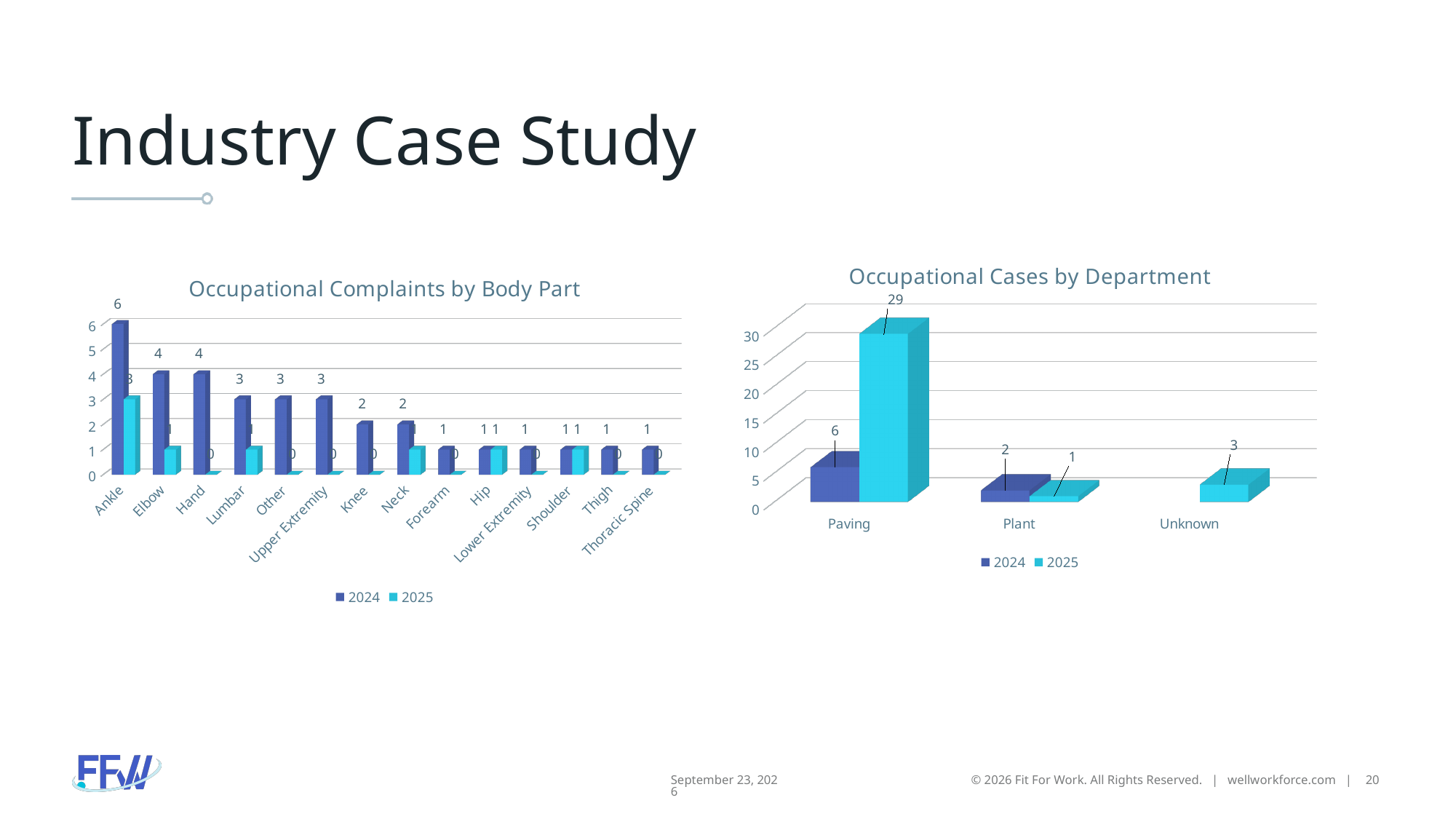
In the Occupational Complaints by Body Part chart, which body part has the highest 2024 value? Ankle In the Occupational Cases by Department chart, what is the value for Paving in 2024? 6 In the Occupational Complaints by Body Part chart, how many series does the legend list? 2 In the Occupational Cases by Department chart, which department has the highest 2025 value? Paving In the Occupational Cases by Department chart, what is the value for Unknown in 2025? 3 In the Occupational Complaints by Body Part chart, what is the 2024 value for Ankle? 6 In the Occupational Complaints by Body Part chart, which is larger for 2024: Hand or Lumbar? Hand In the Occupational Complaints by Body Part chart, how many body part categories are shown on the x axis? 14 In the Occupational Cases by Department chart, what is the value for Paving in 2025? 29 In the Occupational Cases by Department chart, how many departments are shown on the x axis? 3 In the Occupational Cases by Department chart, what is the difference between the 2025 and 2024 values for Paving? 23 What kind of chart is the Occupational Cases by Department chart? Bar chart